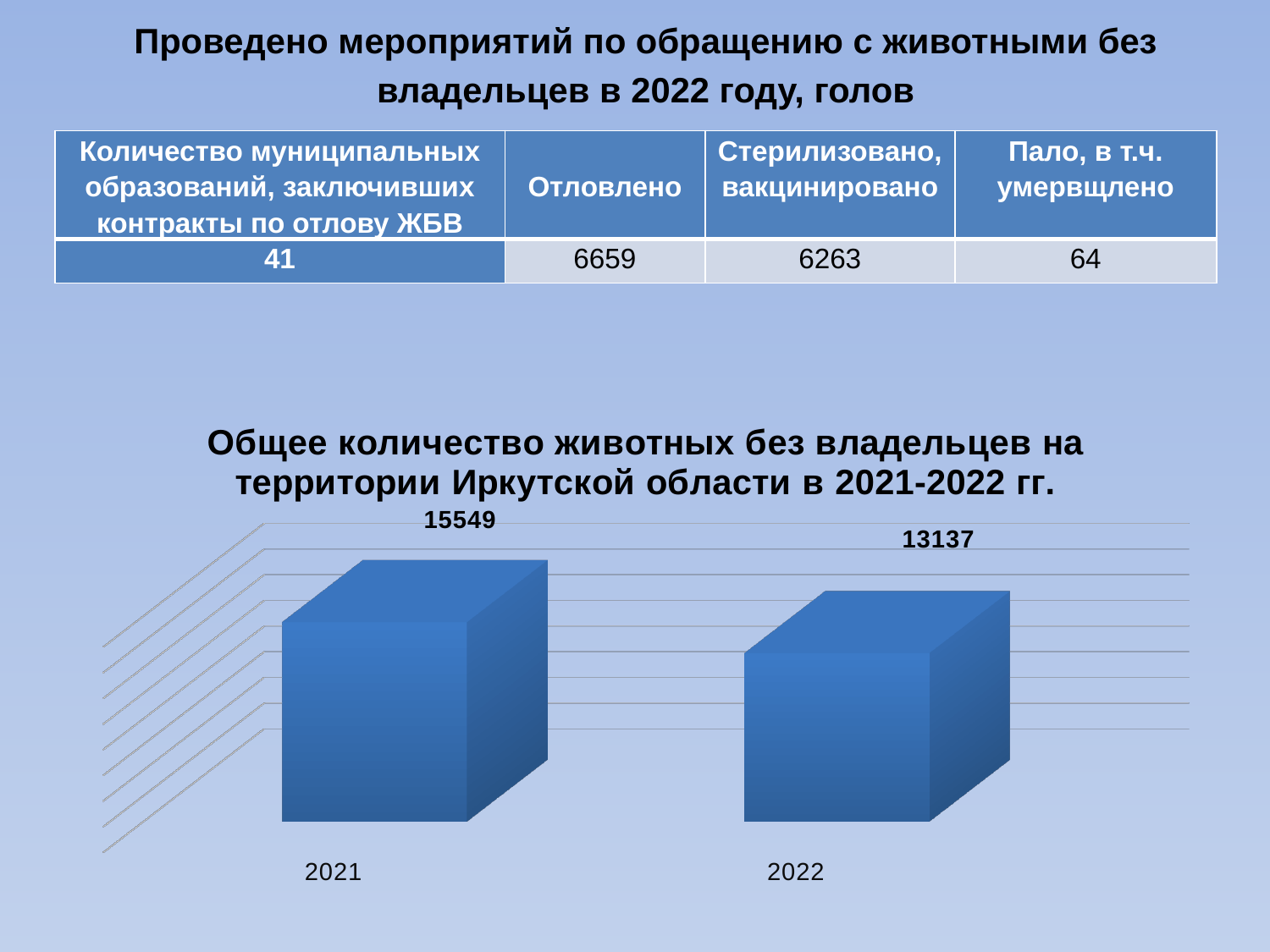
What kind of chart is shown on the slide? bar chart Do the values in the chart rise or fall from 2021 to 2022? fall What is the value for 2022 in the chart? 13137 What is the value for 2021 in the chart? 15549 Which year has the highest value in the chart? 2021 What is the difference between the values for 2021 and 2022 in the chart? 2412 How many categories are shown in the chart? 2 What colour are the bars in the chart? blue Which year has the lowest value in the chart? 2022 What is the title of the chart? Общее количество животных без владельцев на территории Иркутской области в 2021-2022 гг. Which is larger in the chart, the value for 2021 or the value for 2022? 2021